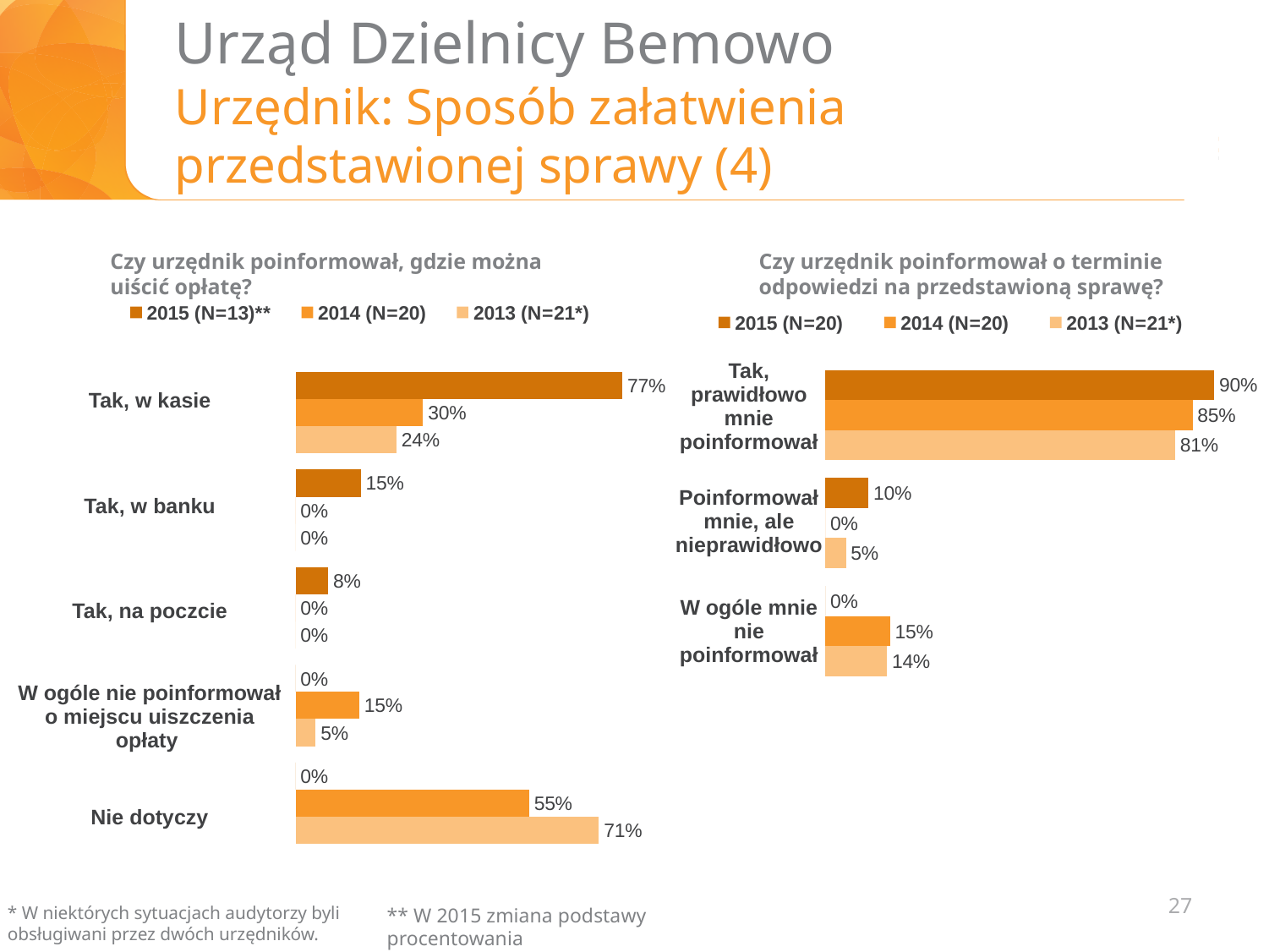
In the right chart (Czy urzędnik poinformował o terminie odpowiedzi na przedstawioną sprawę?), what is the value for 'W ogóle mnie nie poinformował' in 2014? 15% In the left chart (Czy urzędnik poinformował, gdzie można uiścić opłatę?), what is the value for 'Nie dotyczy' in 2013? 71% What type of chart is used on this slide? Bar chart In the left chart (Czy urzędnik poinformował, gdzie można uiścić opłatę?), what is the value for 'Tak, w kasie' in 2015? 77% In the left chart (Czy urzędnik poinformował, gdzie można uiścić opłatę?), how many categories are shown? 5 In the left chart (Czy urzędnik poinformował, gdzie można uiścić opłatę?), how many series does the legend list? 3 In the right chart (Czy urzędnik poinformował o terminie odpowiedzi na przedstawioną sprawę?), what is the difference between the 2015 and 2013 values for 'Tak, prawidłowo mnie poinformował'? 9 percentage points In the left chart (Czy urzędnik poinformował, gdzie można uiścić opłatę?), which category has the highest value for 2014? Nie dotyczy In the left chart (Czy urzędnik poinformował, gdzie można uiścić opłatę?), what is the difference between the 2015 and 2014 values for 'Tak, w kasie'? 47 percentage points In the right chart (Czy urzędnik poinformował o terminie odpowiedzi na przedstawioną sprawę?), what is the value for 'Tak, prawidłowo mnie poinformował' in 2013? 81% In the right chart (Czy urzędnik poinformował o terminie odpowiedzi na przedstawioną sprawę?), how many categories are shown? 3 In the right chart (Czy urzędnik poinformował o terminie odpowiedzi na przedstawioną sprawę?), which is larger for 'Poinformował mnie, ale nieprawidłowo': the 2015 value or the 2013 value? 2015